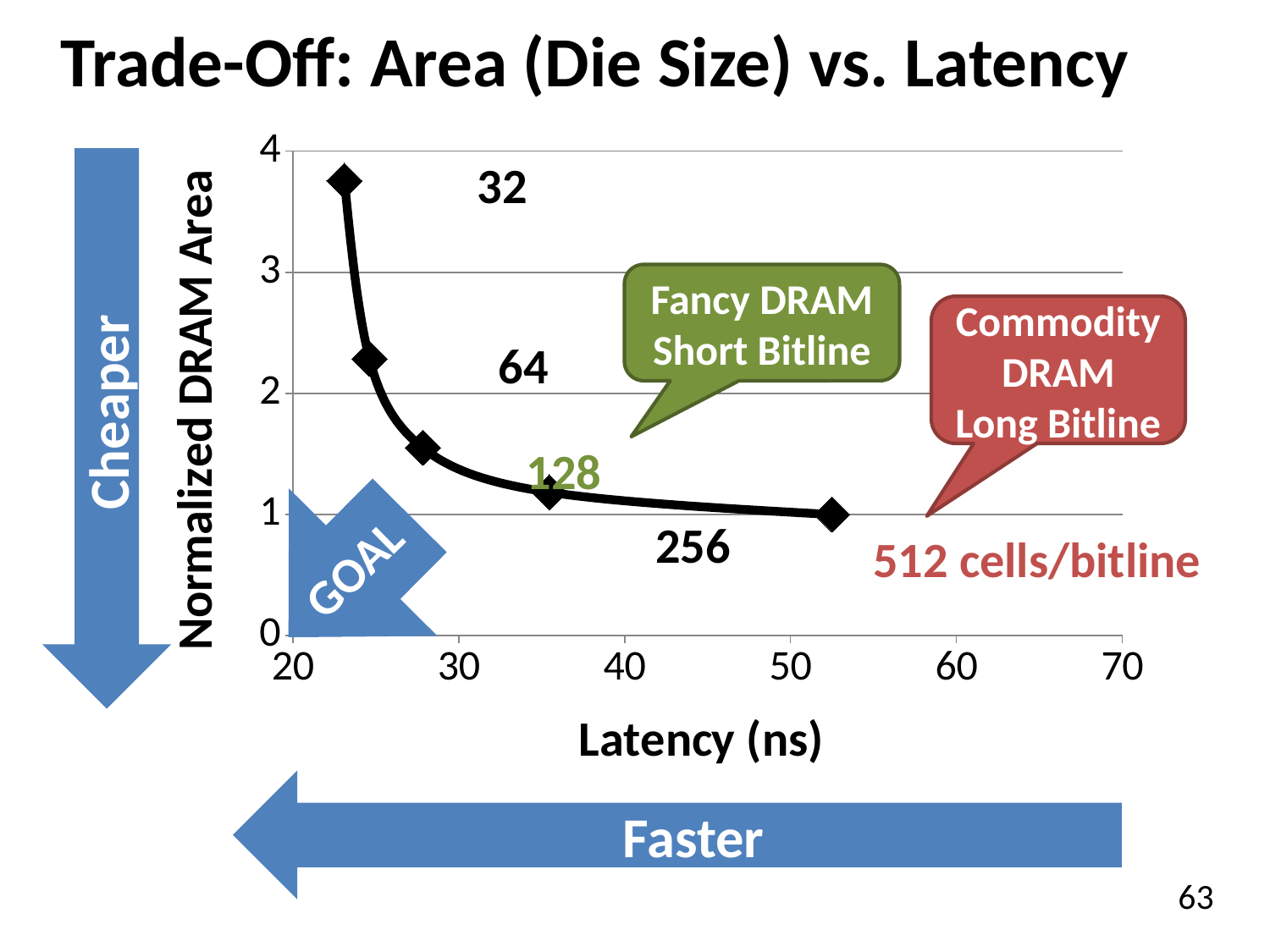
Is the latency for 256 cells/bitline greater or less than 40 ns? less Which cells/bitline configuration has the highest normalized DRAM area? 32 What kind of chart is shown on the slide? line chart Which has a larger normalized DRAM area, 64 cells/bitline or 128 cells/bitline? 64 cells/bitline How many data points are plotted on the chart? 5 Which cells/bitline configuration has the lowest latency? 32 Is the normalized DRAM area for 64 cells/bitline greater or less than 2? greater Is the normalized DRAM area for 128 cells/bitline greater or less than 2? less As latency increases along the x axis, does normalized DRAM area rise or fall? fall Which cells/bitline configuration has the highest latency? 512